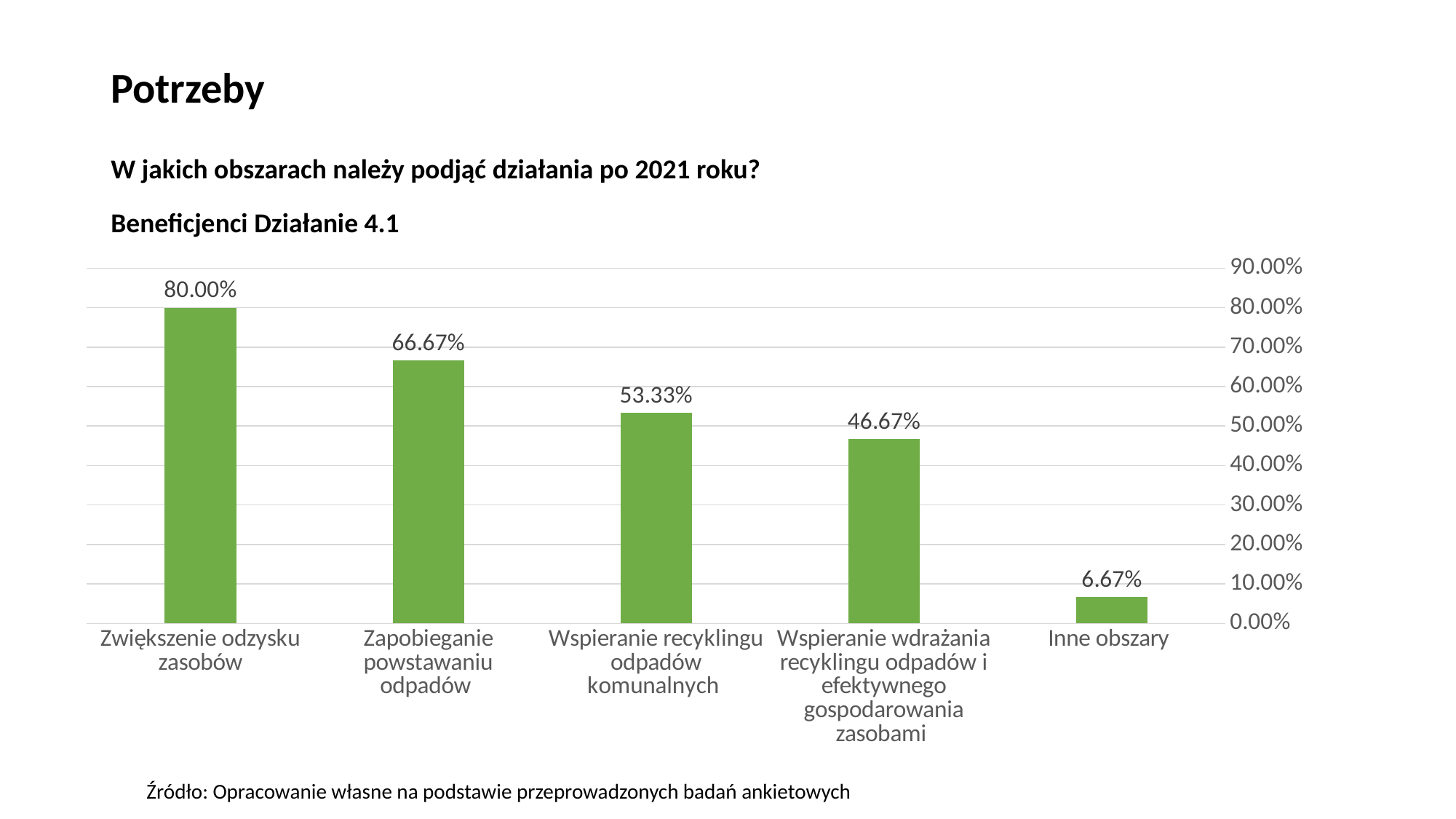
What is the value for "Zwiększenie odzysku zasobów"? 80.00% Which is larger: the value for "Wspieranie recyklingu odpadów komunalnych" or for "Wspieranie wdrażania recyklingu odpadów i efektywnego gospodarowania zasobami"? Wspieranie recyklingu odpadów komunalnych Do the values rise or fall from left to right across the categories? Fall Which category has the highest value? Zwiększenie odzysku zasobów What is the difference between the values for "Zwiększenie odzysku zasobów" and "Zapobieganie powstawaniu odpadów"? 13.33% How many categories are shown in the chart? 5 What is the highest value shown on the vertical axis? 90.00% What is the value for "Inne obszary"? 6.67% Is the value for "Zapobieganie powstawaniu odpadów" greater or less than 60.00%? greater What is the value for "Wspieranie recyklingu odpadów komunalnych"? 53.33% Which category has the lowest value? Inne obszary What kind of chart is shown on the slide? Bar chart